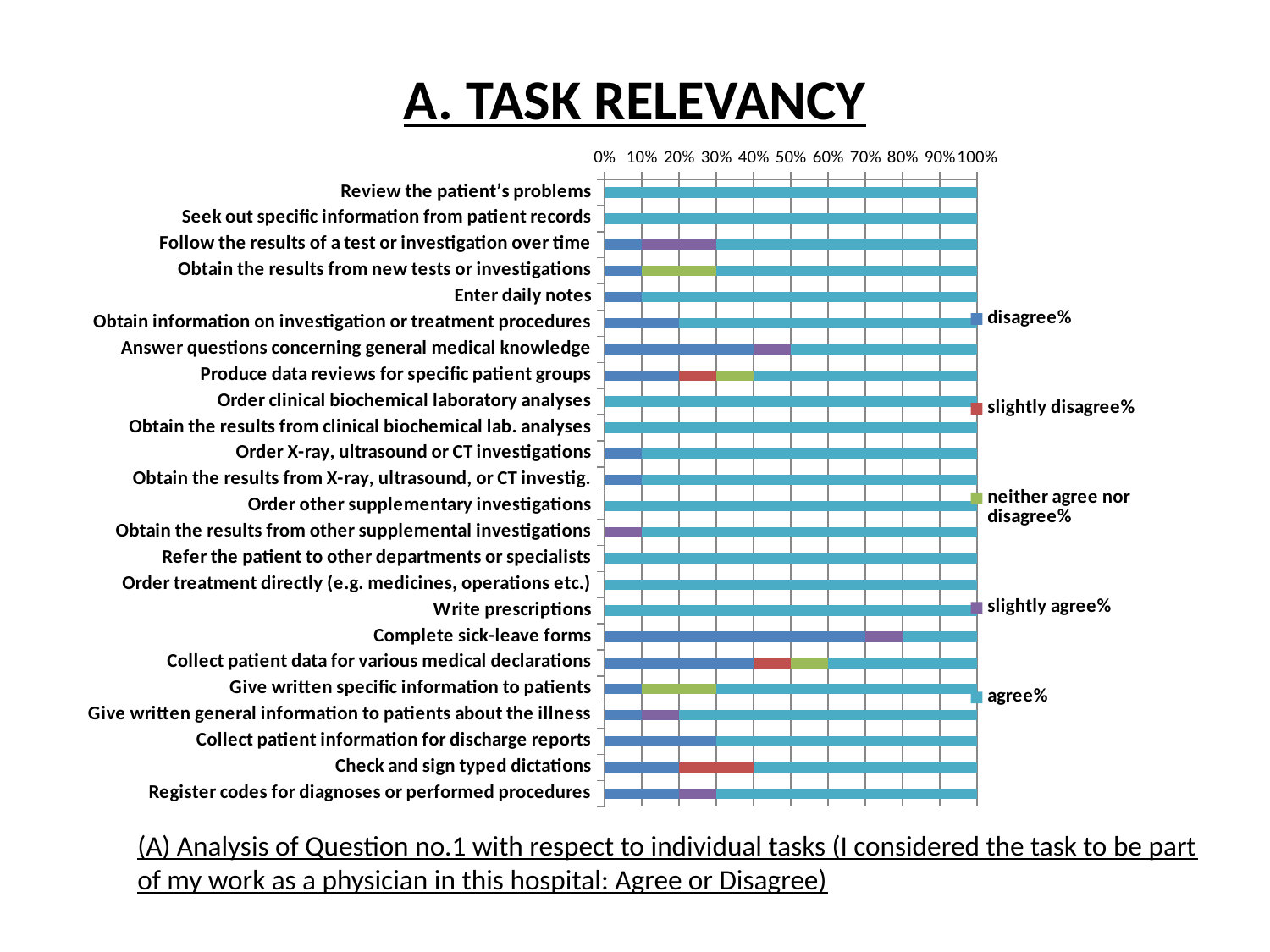
Is the agree% value for 'Complete sick-leave forms' greater or less than 30%? less How many tasks (categories) are listed on the vertical axis of the chart? 24 Is the disagree% value for 'Complete sick-leave forms' greater or less than 50%? greater Which task has the smallest agree% segment? Complete sick-leave forms What kind of chart is shown on the slide? bar chart Which task has the largest disagree% segment? Complete sick-leave forms Which legend entry is shown in the light blue colour that makes up most of each bar? agree% What is the title of the chart on the slide? A. TASK RELEVANCY Which task has the larger disagree% segment: 'Complete sick-leave forms' or 'Answer questions concerning general medical knowledge'? Complete sick-leave forms How many series does the chart's legend list? 5 Is the disagree% value for 'Collect patient data for various medical declarations' greater or less than 30%? greater What is the agree% value for 'Review the patient's problems'? 100%